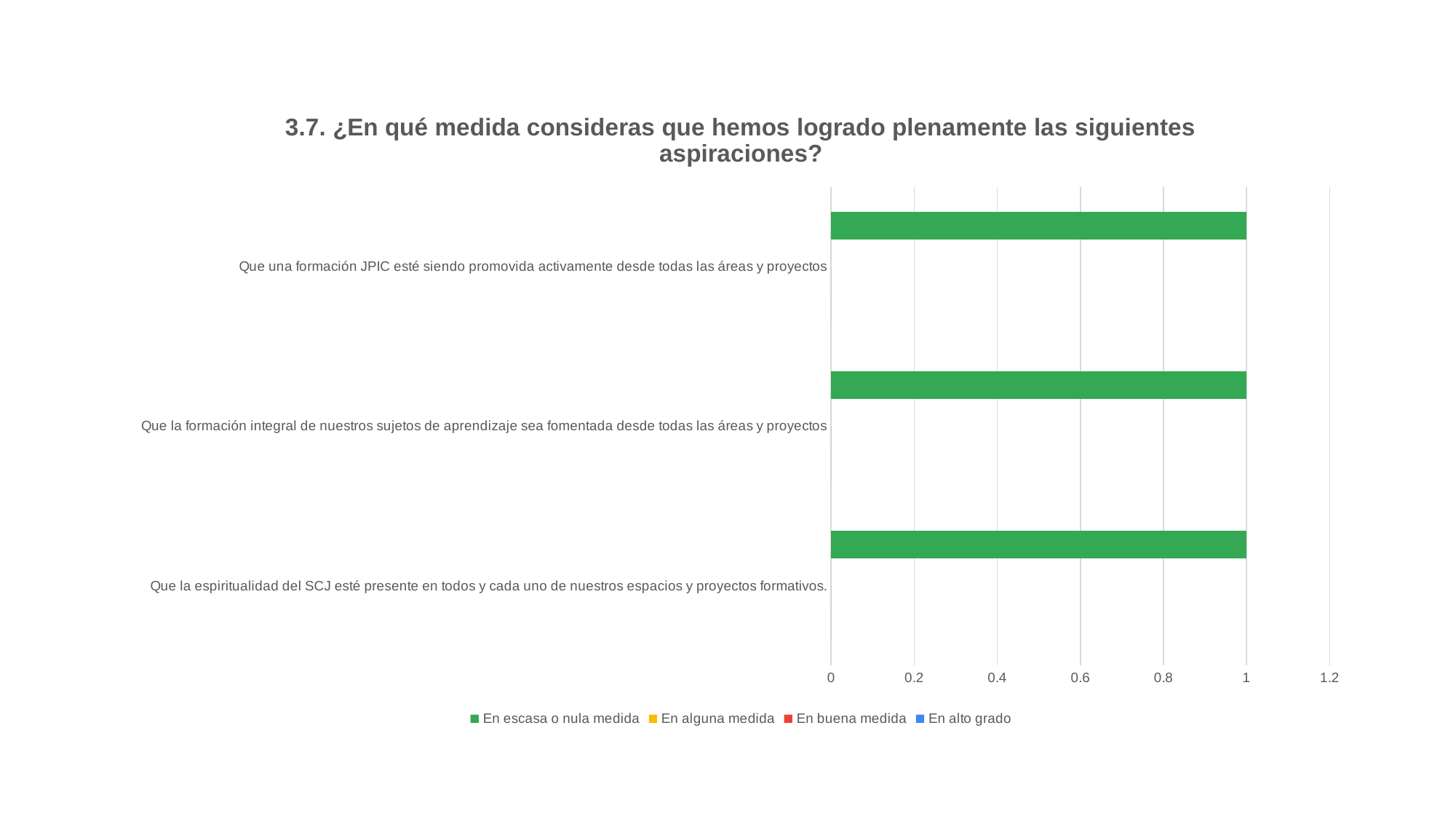
Is the 'En escasa o nula medida' value for 'Que una formación JPIC esté siendo promovida activamente desde todas las áreas y proyectos' greater or less than 1.2? less Which legend entry is shown in green? En escasa o nula medida What is the value of 'En escasa o nula medida' for 'Que la formación integral de nuestros sujetos de aprendizaje sea fomentada desde todas las áreas y proyectos'? 1 What is the highest value shown on the horizontal axis of the chart? 1.2 How many categories (aspirations) are listed on the vertical axis of the chart? 3 What is the value of 'En escasa o nula medida' for 'Que una formación JPIC esté siendo promovida activamente desde todas las áreas y proyectos'? 1 Is the 'En escasa o nula medida' value for 'Que la formación integral de nuestros sujetos de aprendizaje sea fomentada desde todas las áreas y proyectos' greater or less than 0.8? greater How many series does the legend of the chart list? 4 What is the value of 'En escasa o nula medida' for 'Que la espiritualidad del SCJ esté presente en todos y cada uno de nuestros espacios y proyectos formativos.'? 1 What kind of chart is shown on the slide? bar chart